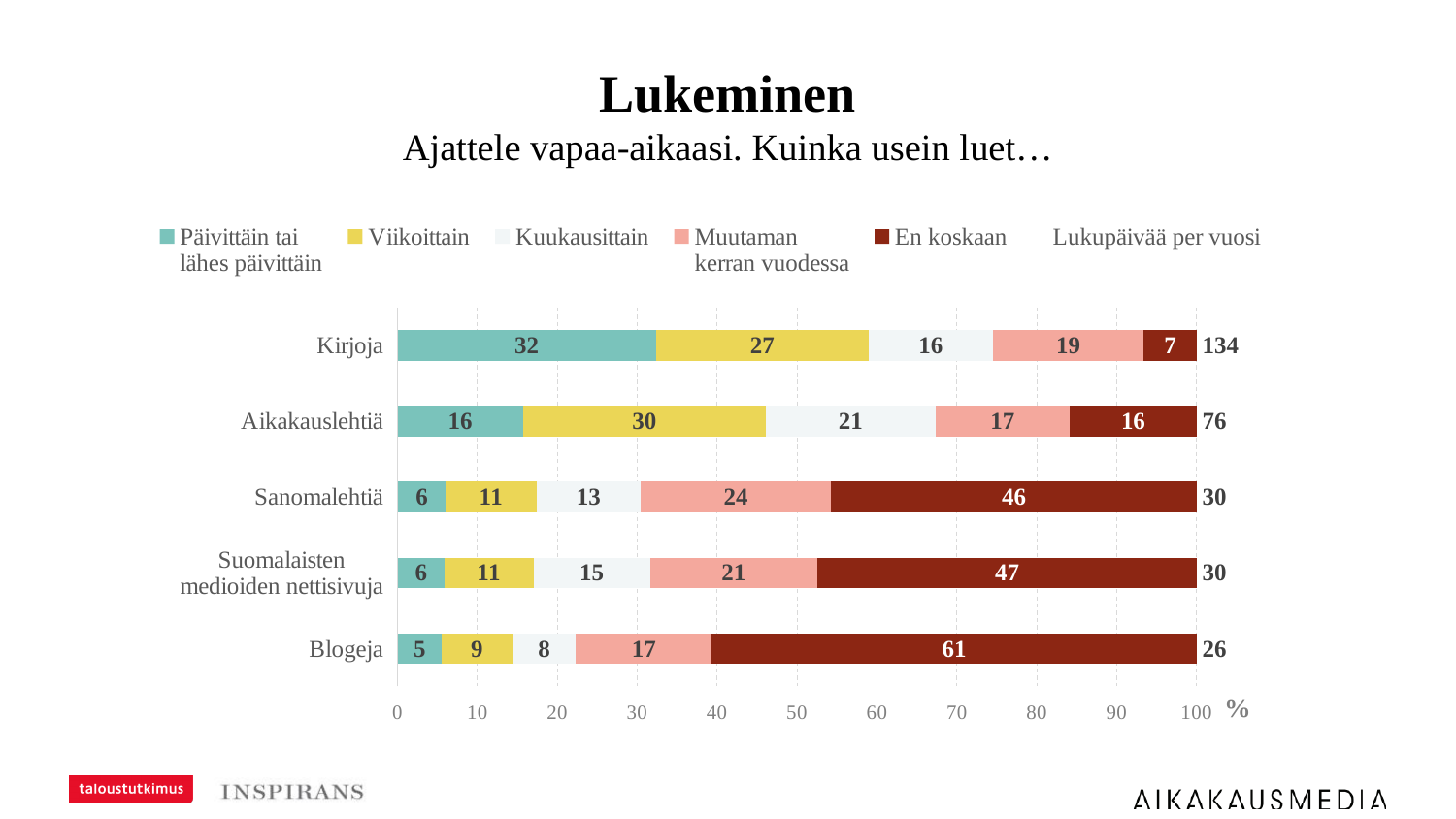
Which category has the highest 'Lukupäivää per vuosi' value? Kirjoja How much larger is the 'Päivittäin tai lähes päivittäin' value for Kirjoja than for Aikakauslehtiä? 16 How many categories are shown on the chart? 5 What percentage of respondents read Kirjoja 'Päivittäin tai lähes päivittäin'? 32 What is the difference in 'Lukupäivää per vuosi' between Kirjoja and Aikakauslehtiä? 58 Which category has the largest 'En koskaan' share? Blogeja What type of chart is shown on the slide? Stacked bar chart What is the 'Muutaman kerran vuodessa' value for Sanomalehtiä? 24 What is the 'En koskaan' value for Blogeja? 61 Which has a larger 'Viikoittain' value, Kirjoja or Aikakauslehtiä? Aikakauslehtiä Which category has the lowest 'Lukupäivää per vuosi' value? Blogeja How many 'Lukupäivää per vuosi' are shown for Aikakauslehtiä? 76